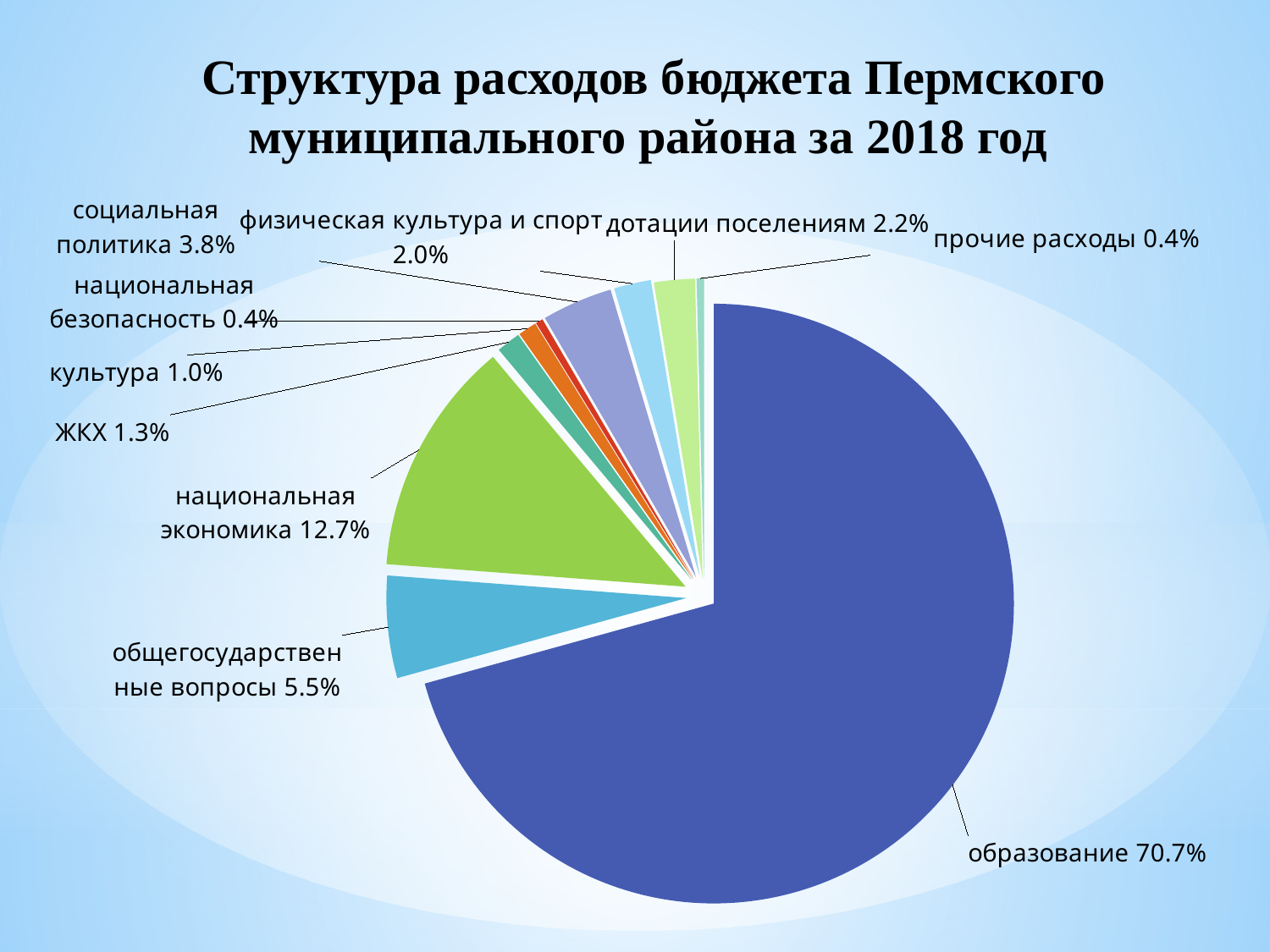
Which is larger: физическая культура и спорт or культура? физическая культура и спорт What is the difference between the shares of образование and национальная экономика? 58.0% What is the value for национальная экономика? 12.7% What is the title of the chart on the slide? Структура расходов бюджета Пермского муниципального района за 2018 год What is the value for дотации поселениям? 2.2% What kind of chart is shown on the slide? pie chart What is the value for ЖКХ? 1.3% What is the value for общегосударственные вопросы? 5.5% Which category has the largest share of the pie? образование What is the value for социальная политика? 3.8% What share of the budget expenditure goes to образование? 70.7% How many categories are shown in the pie chart? 10